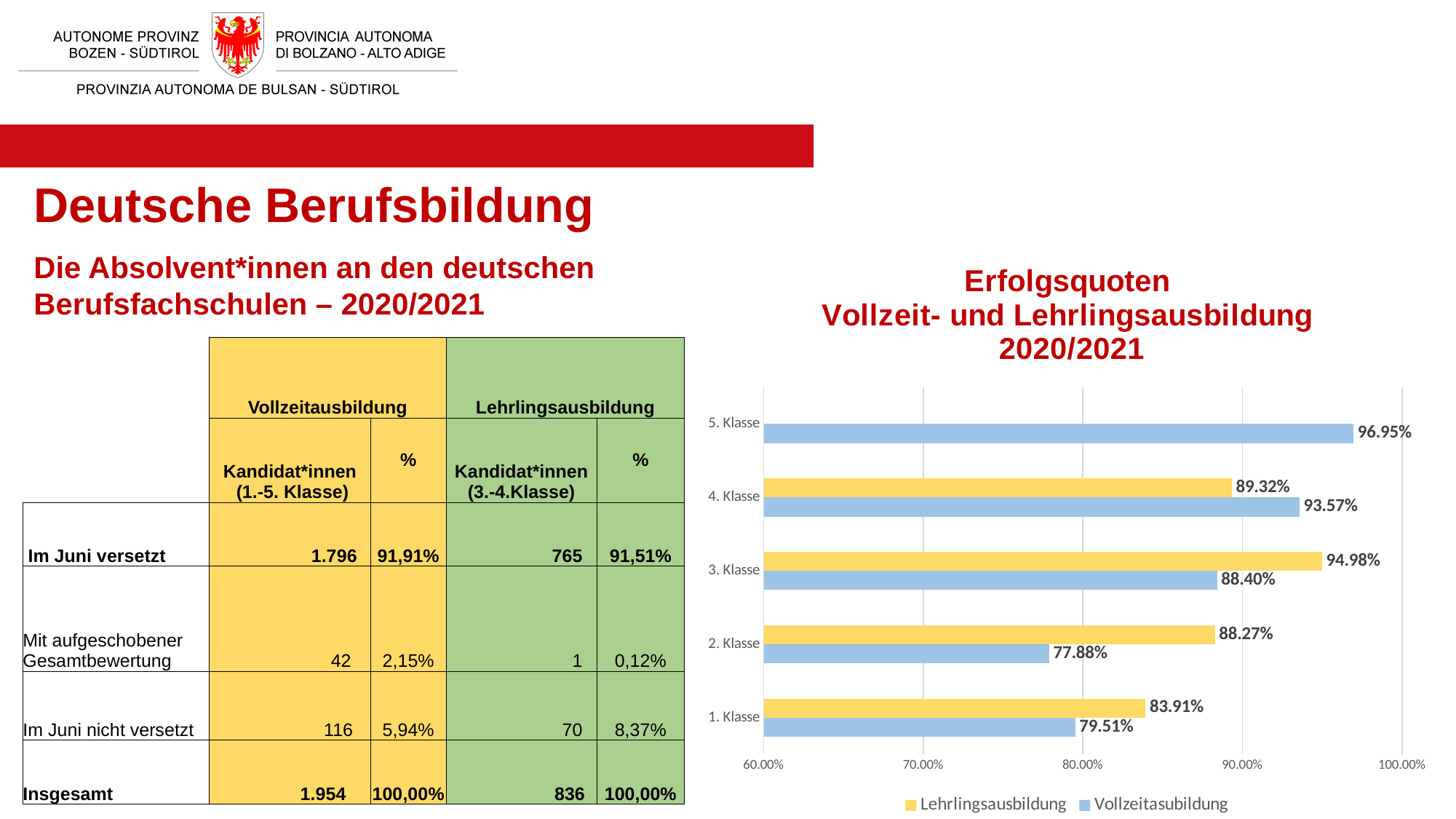
For 4. Klasse, which is larger: Lehrlingsausbildung or Vollzeitausbildung? Vollzeitausbildung Is the Vollzeitausbildung value for 1. Klasse greater or less than 80.00%? less How many series does the chart legend list? 2 What is the Vollzeitausbildung value for 5. Klasse? 96.95% What is the difference between the Lehrlingsausbildung and Vollzeitausbildung values for 2. Klasse? 10.39% What is the Lehrlingsausbildung value for 3. Klasse? 94.98% How many Klasse categories are shown on the chart? 5 Which Klasse has the lowest Lehrlingsausbildung value? 1. Klasse What is the Lehrlingsausbildung value for 1. Klasse? 83.91% What is the Vollzeitausbildung value for 2. Klasse? 77.88% Which Klasse has the highest Vollzeitausbildung value? 5. Klasse What type of chart is shown on the slide? Bar chart